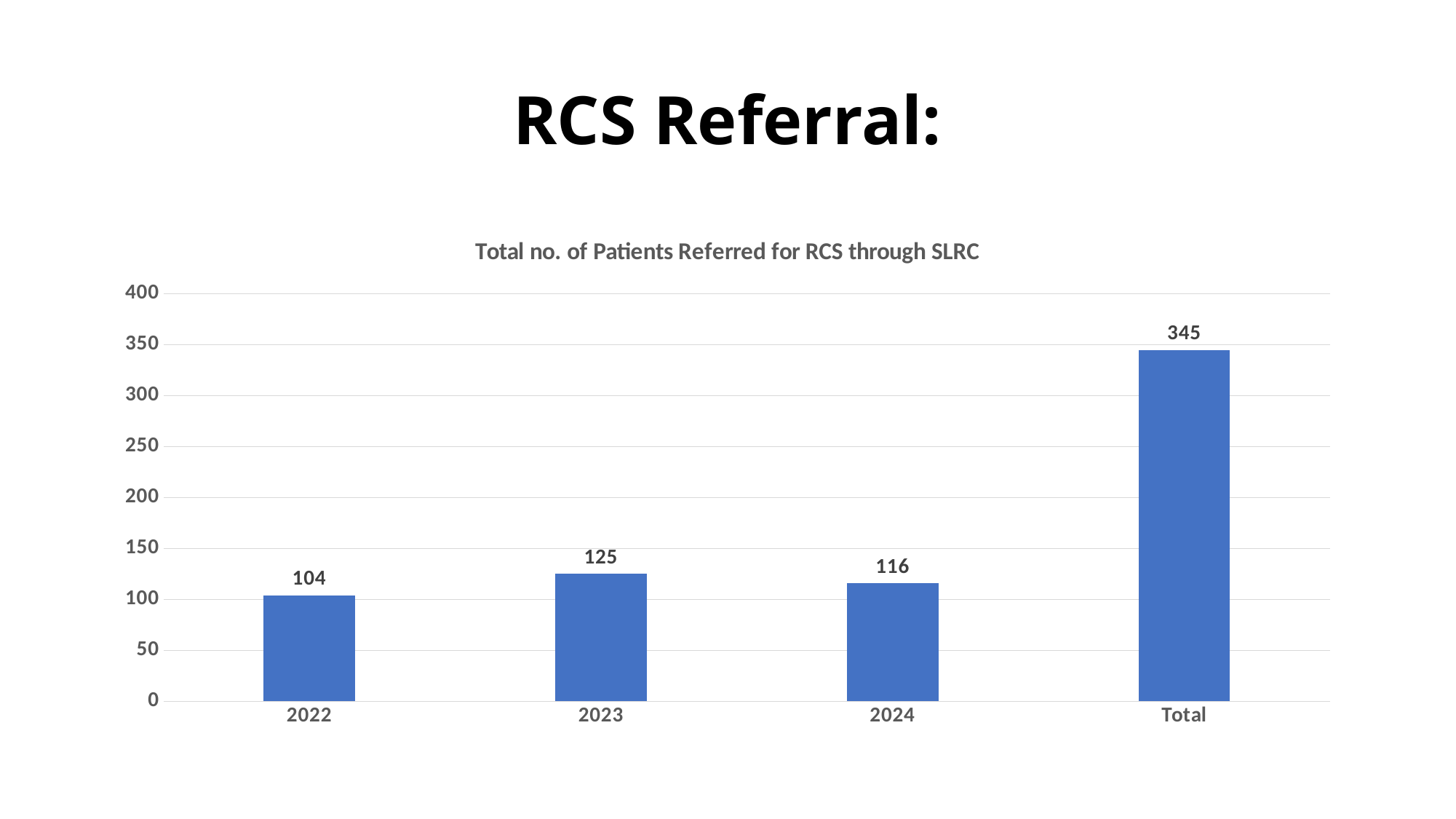
What is the title of the chart? Total no. of Patients Referred for RCS through SLRC Which category has the lowest value? 2022 Is the value for 2023 greater or less than 100? greater What is the value for 2023? 125 What is the value for 2022? 104 What is the difference between the values for 2023 and 2022? 21 Which is larger, the value for 2024 or the value for 2022? 2024 What kind of chart is shown on the slide? Bar chart What is the value for 2024? 116 Which of the three years (2022, 2023, 2024) has the highest number of patients referred? 2023 How many bars are shown in the chart? 4 What is the value for the Total bar? 345